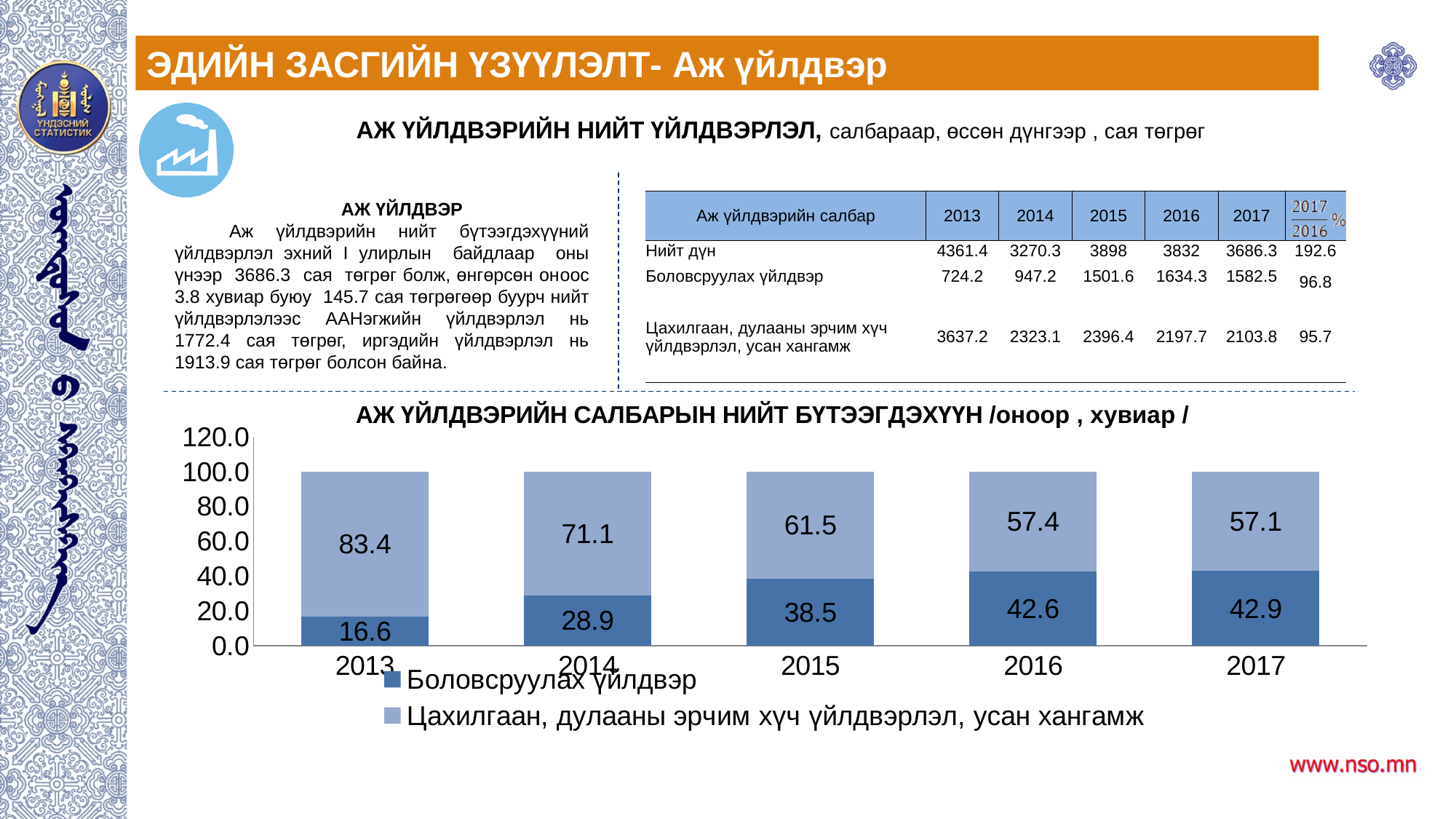
What type of chart is shown on the slide? stacked bar chart How many series does the legend list? 2 What is the total of the stacked bar for 2016? 100.0 Does the value for Боловсруулах үйлдвэр rise or fall from 2013 to 2017? rise In which year is the value for Цахилгаан, дулааны эрчим хүч үйлдвэрлэл, усан хангамж the lowest? 2017 What is the value for Боловсруулах үйлдвэр in 2017? 42.9 In which year is the value for Боловсруулах үйлдвэр the highest? 2017 What is the value for Боловсруулах үйлдвэр in 2013? 16.6 What is the value for Цахилгаан, дулааны эрчим хүч үйлдвэрлэл, усан хангамж in 2015? 61.5 What is the difference between the two series' values in 2013? 66.8 Which series has the larger value in 2014? Цахилгаан, дулааны эрчим хүч үйлдвэрлэл, усан хангамж How many years are shown on the x axis? 5